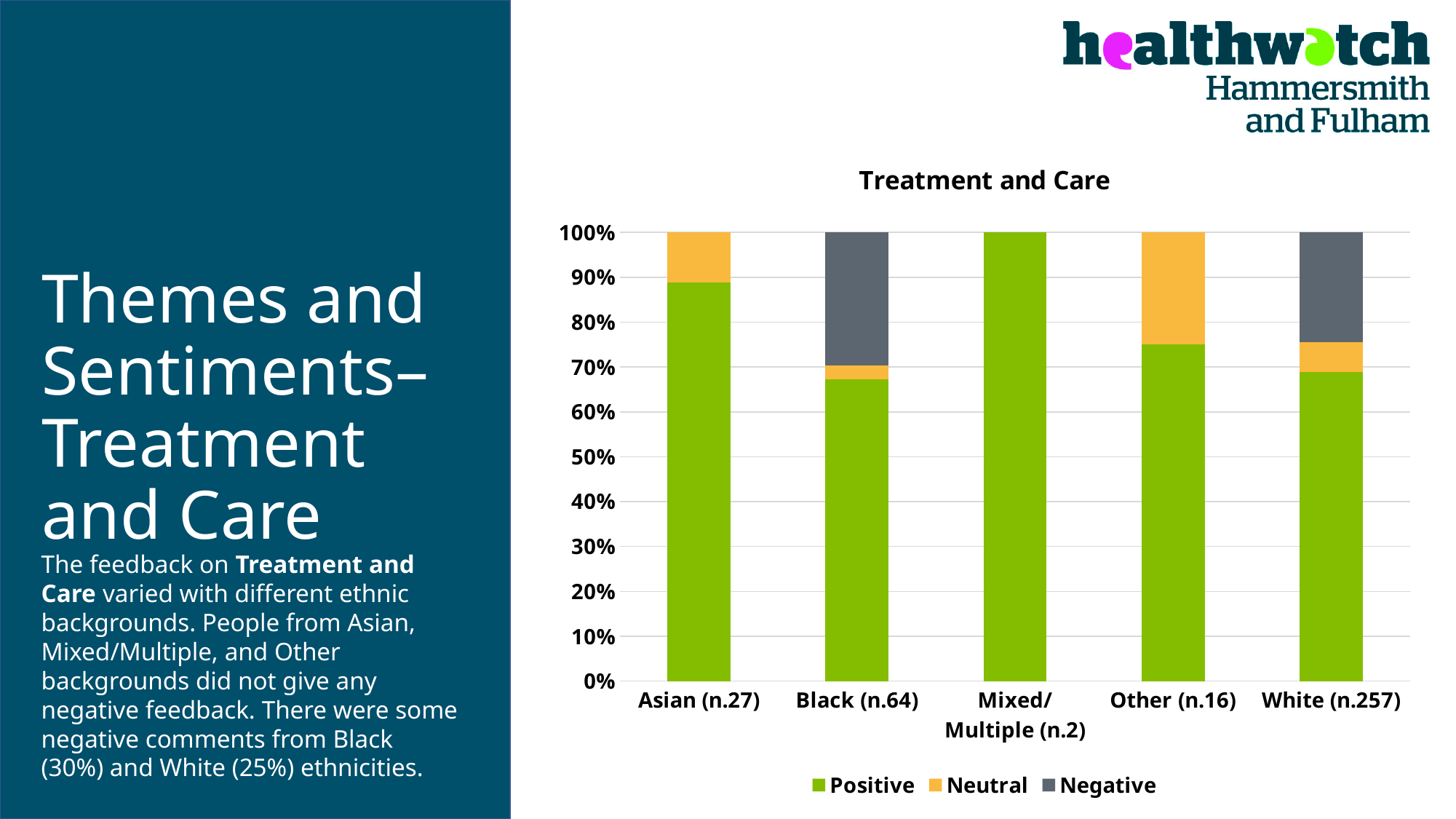
What is the title of the chart? Treatment and Care How many ethnic group categories are shown on the x axis? 5 How many series does the legend list? 3 What kind of chart is shown on the slide? bar chart Is the Positive value for Black (n.64) greater or less than 60%? greater Which category has the highest Positive share? Mixed/Multiple (n.2) What is the Positive share for Mixed/Multiple (n.2)? 100% Is the Positive value for White (n.257) greater or less than 80%? less Which category has the largest Neutral share? Other (n.16) Which colour represents the Negative series in the legend? grey Which is larger, the Positive share for Asian (n.27) or for White (n.257)? Asian (n.27) Is the Positive value for Asian (n.27) greater or less than 80%? greater